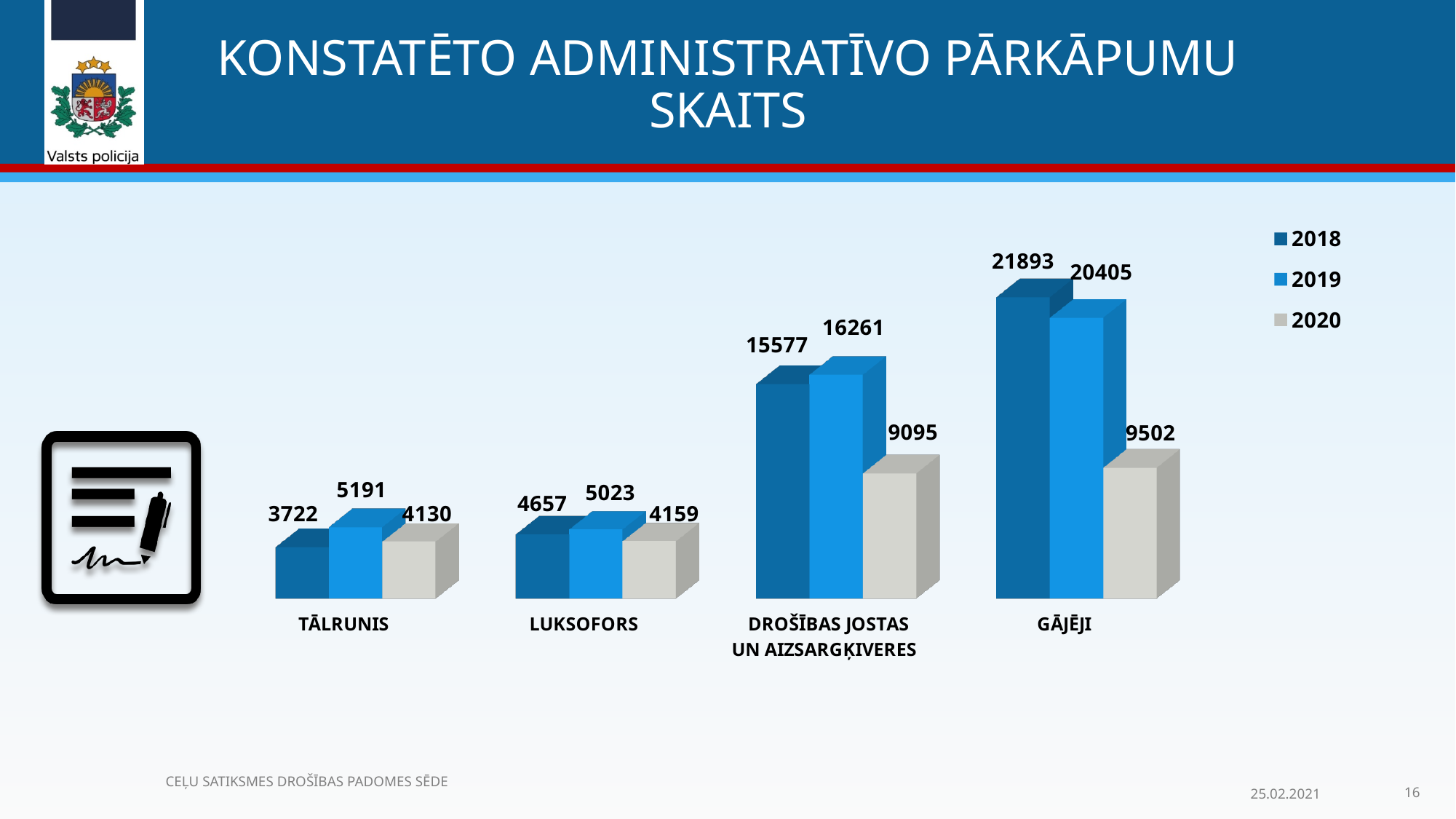
What is the value for GĀJĒJI in 2018? 21893 Which years are listed in the legend? 2018, 2019, 2020 What is the 2020 value for DROŠĪBAS JOSTAS UN AIZSARGĶIVERES? 9095 Which is larger for DROŠĪBAS JOSTAS UN AIZSARGĶIVERES: the 2018 value or the 2019 value? 2019 What is the value for LUKSOFORS in 2020? 4159 What is the difference between the 2018 and 2020 values for GĀJĒJI? 12391 What is the value for TĀLRUNIS in 2019? 5191 How many categories are shown on the x axis? 4 Which category has the highest value in 2019? GĀJĒJI What kind of chart is shown on the slide? Bar chart How many series does the legend list? 3 Which category has the lowest value in 2018? TĀLRUNIS